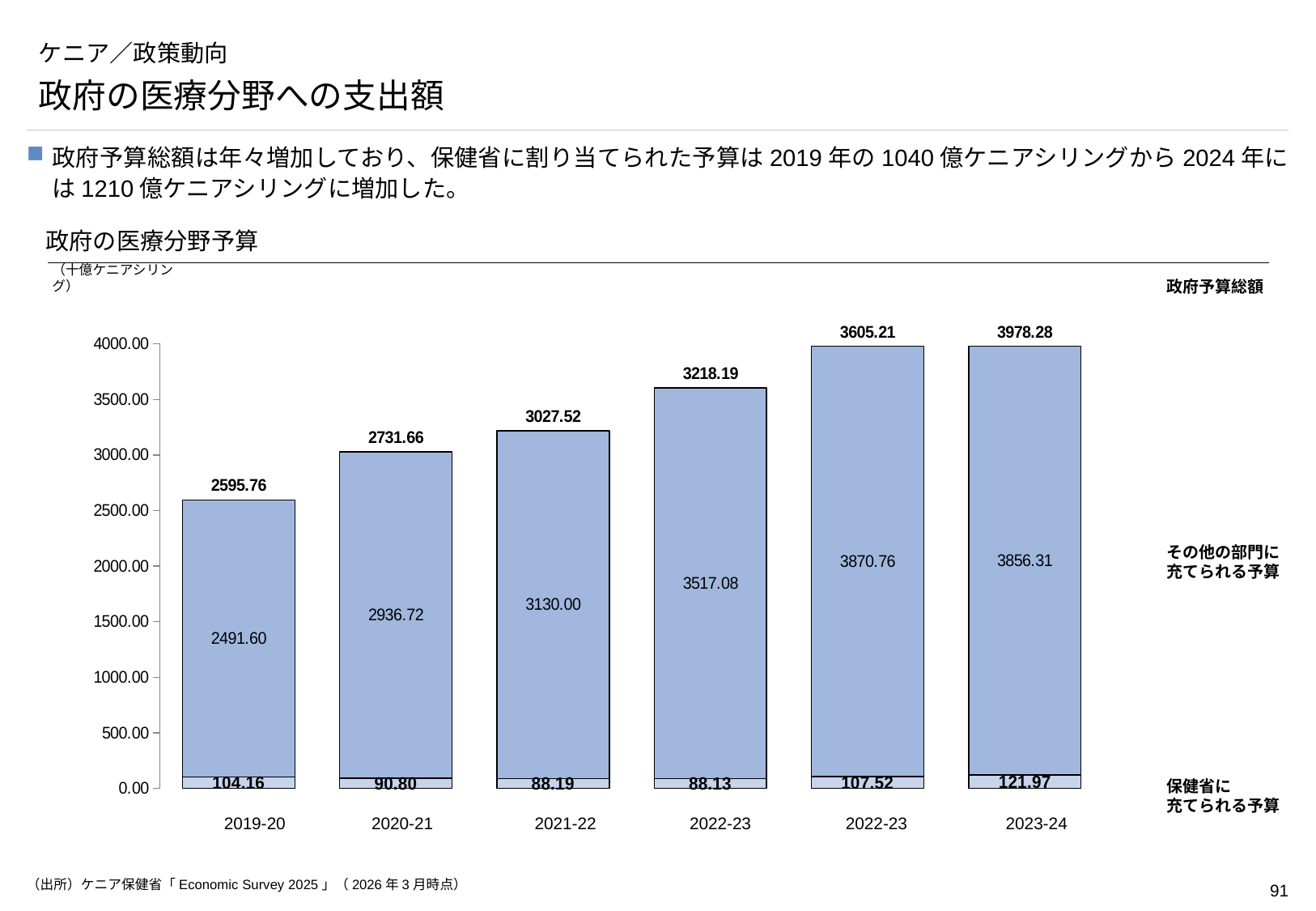
What kind of chart is shown on the slide? Stacked bar chart What is the value of the その他の部門に充てられる予算 segment for 2021-22? 3130.00 How many bars are shown in the chart? 6 Which fiscal year has the lowest total government budget? 2019-20 What is the total government budget (政府予算総額) shown above the bar for 2019-20? 2595.76 What is the difference between the total government budget for 2023-24 and for 2019-20? 1382.52 Which fiscal year has the highest total government budget? 2023-24 How many series are stacked in each bar? 2 What is the value of the 保健省に充てられる予算 segment for 2023-24? 121.97 What is the difference between the 保健省に充てられる予算 value for 2023-24 and for 2019-20? 17.81 Which is larger, the 保健省に充てられる予算 value for 2019-20 or for 2020-21? 2019-20 Is the total government budget for 2020-21 greater or less than 3000? less